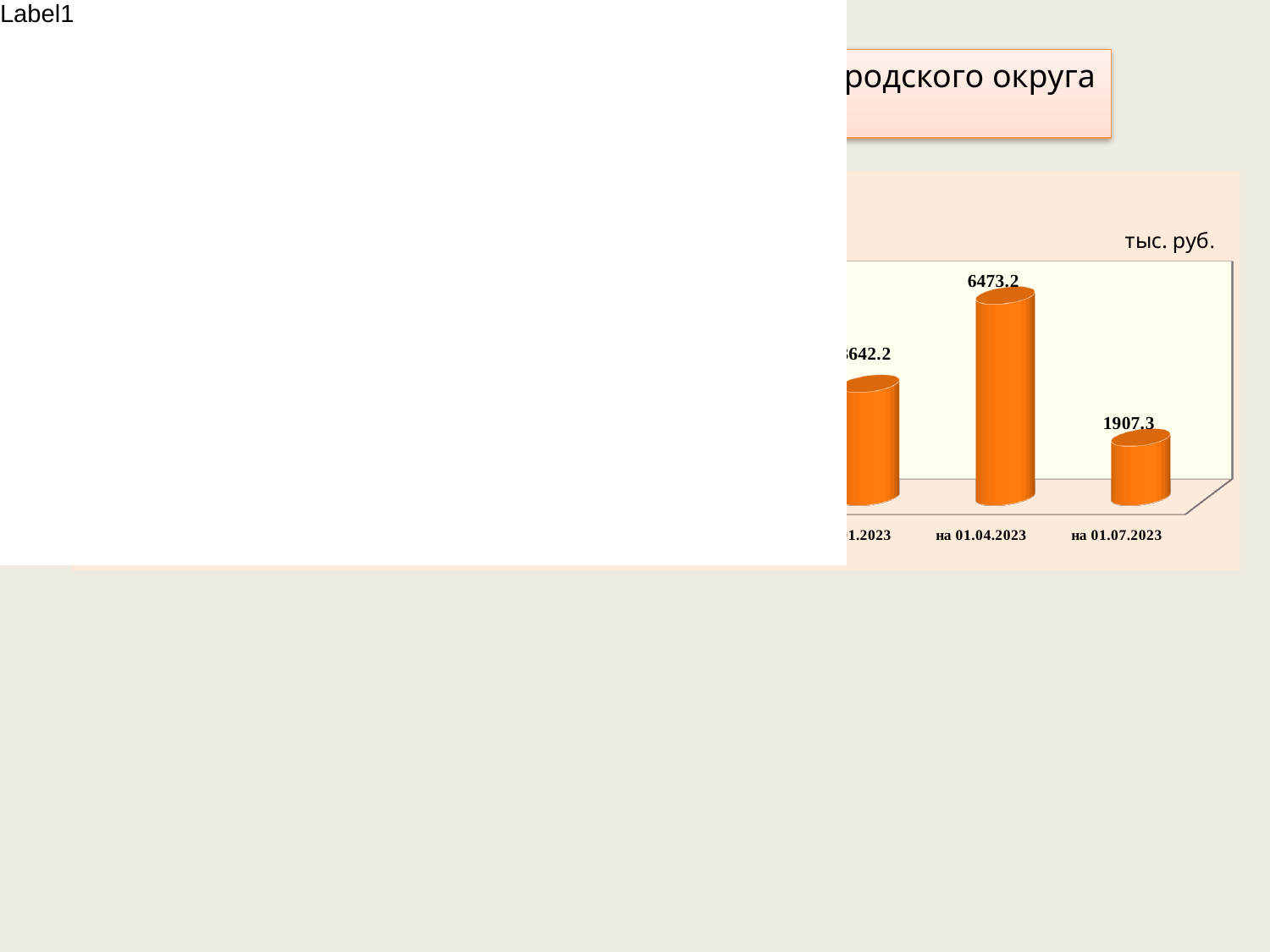
What unit is shown above the chart? тыс. руб. Which is larger, the value for на 01.04.2023 or the value for на 01.07.2023? на 01.04.2023 What is the difference between the values for на 01.04.2023 and на 01.07.2023? 4565.9 What is the value for на 01.04.2023? 6473.2 What is the value for на 01.07.2023? 1907.3 Which visible category has the highest value? на 01.04.2023 What kind of chart is shown on the slide? bar chart Does the value rise or fall from на 01.04.2023 to на 01.07.2023? fall What colour are the bars in the chart? orange Which visible category has the lowest value? на 01.07.2023